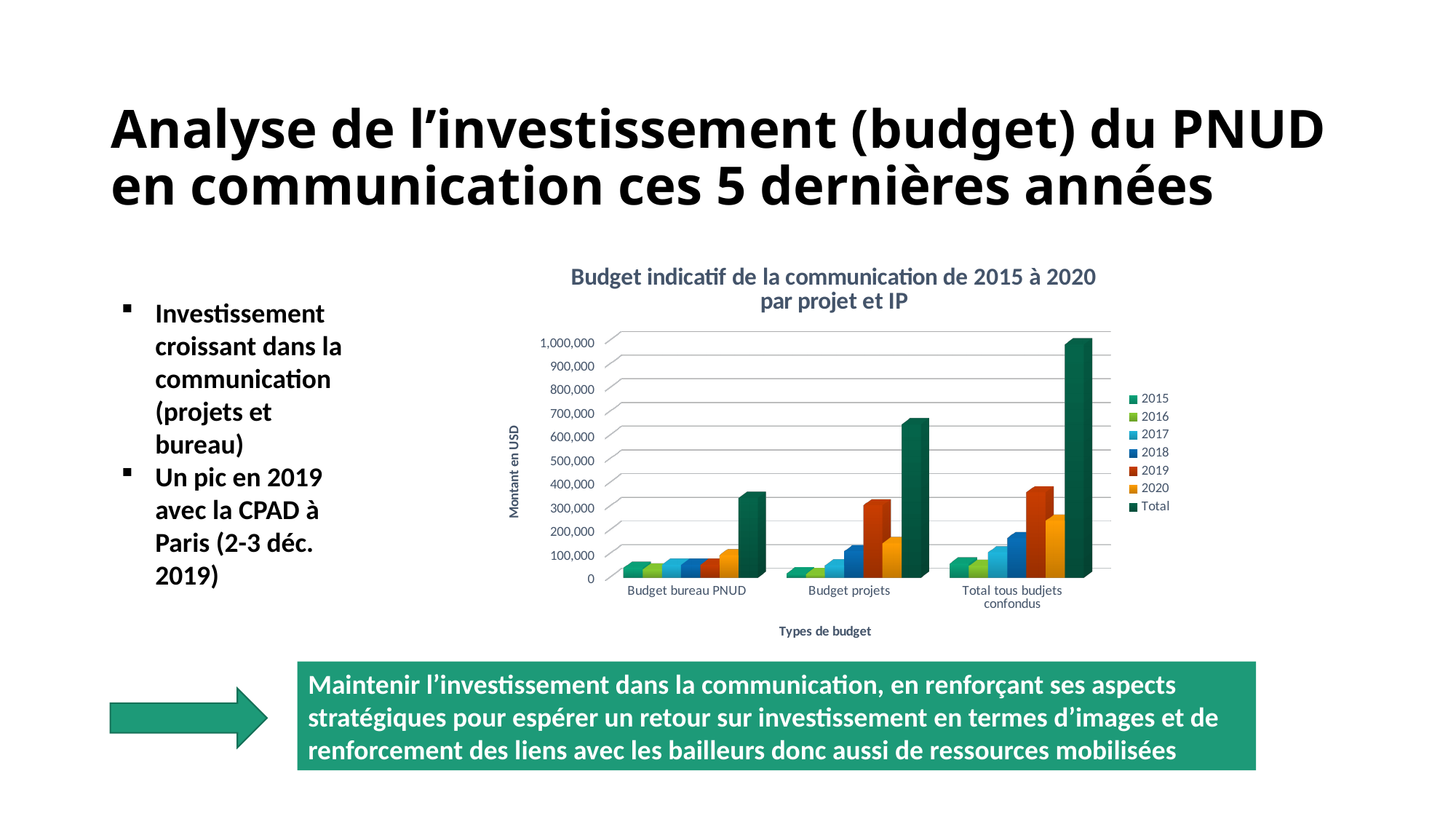
Is the 2019 value for 'Budget projets' greater or less than 200,000? greater What is the title of the chart? Budget indicatif de la communication de 2015 à 2020 par projet et IP Among the years 2015 to 2020, which year has the highest value for 'Budget projets'? 2019 For 'Total tous budjets confondus', which is larger: the 2019 value or the 2020 value? 2019 How many budget categories are shown on the x axis of the chart? 3 Is the Total value for 'Total tous budjets confondus' greater or less than 900,000? greater How many series does the chart legend list? 7 What kind of chart is shown on the slide? Bar chart Is the Total value for 'Budget projets' greater or less than 600,000? greater What is the label of the vertical axis of the chart? Montant en USD